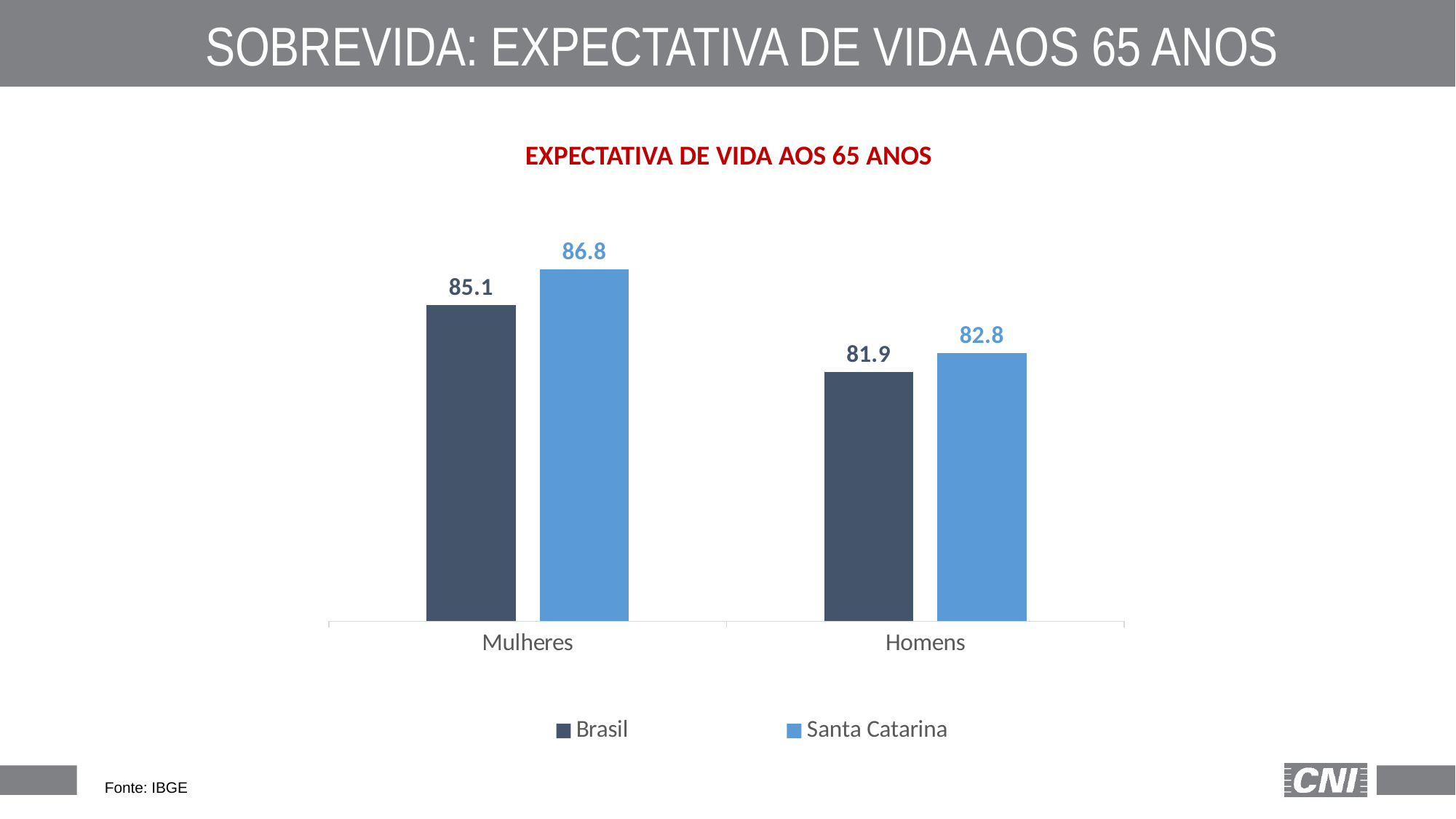
What is the difference between Santa Catarina and Brasil in the Homens category? 0.9 How many series does the legend list? 2 What is the value for Santa Catarina in the Homens category? 82.8 What is the value for Brasil in the Homens category? 81.9 What is the difference between Santa Catarina and Brasil in the Mulheres category? 1.7 Which bar has the highest value on the chart? Santa Catarina, Mulheres What is the value for Santa Catarina in the Mulheres category? 86.8 Which is larger: Brasil for Mulheres or Santa Catarina for Homens? Brasil for Mulheres What is the value for Brasil in the Mulheres category? 85.1 Which bar has the lowest value on the chart? Brasil, Homens How many categories are shown on the x axis? 2 What kind of chart is shown on the slide? Bar chart